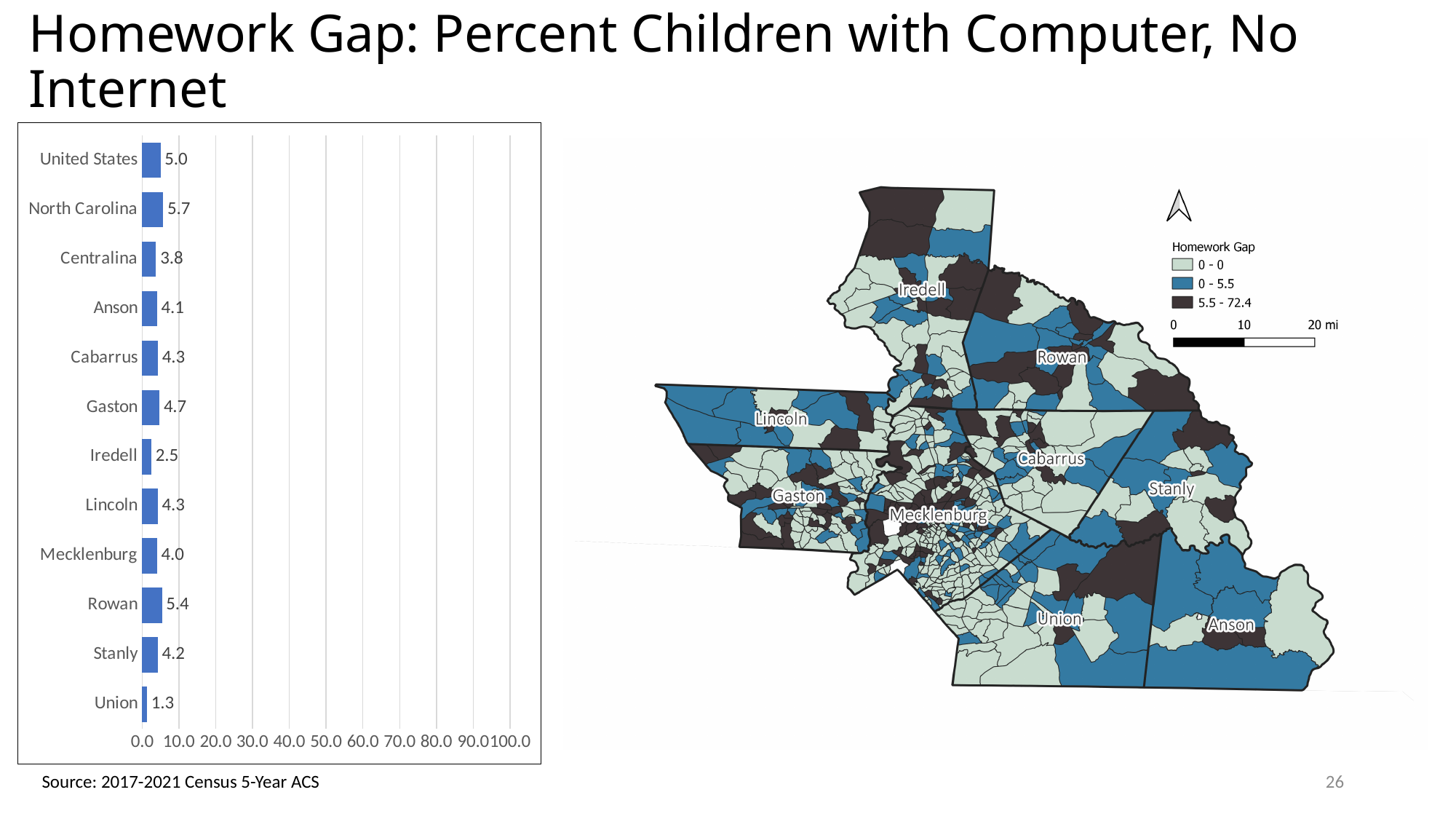
Is the value for Centralina in the bar chart greater or less than 10.0? less What is the difference between the values for North Carolina and the United States in the bar chart? 0.7 How many categories are shown in the bar chart? 12 Which category has the highest value in the bar chart? North Carolina Which has a larger value in the bar chart, Rowan or Gaston? Rowan What is the value for Union in the bar chart? 1.3 Which category has the lowest value in the bar chart? Union What is the value for North Carolina in the bar chart? 5.7 What is the value for Mecklenburg in the bar chart? 4.0 What is the difference between the values for Iredell and Union in the bar chart? 1.2 What is the highest value shown on the x axis of the bar chart? 100.0 What kind of chart is shown on the left of the slide? bar chart